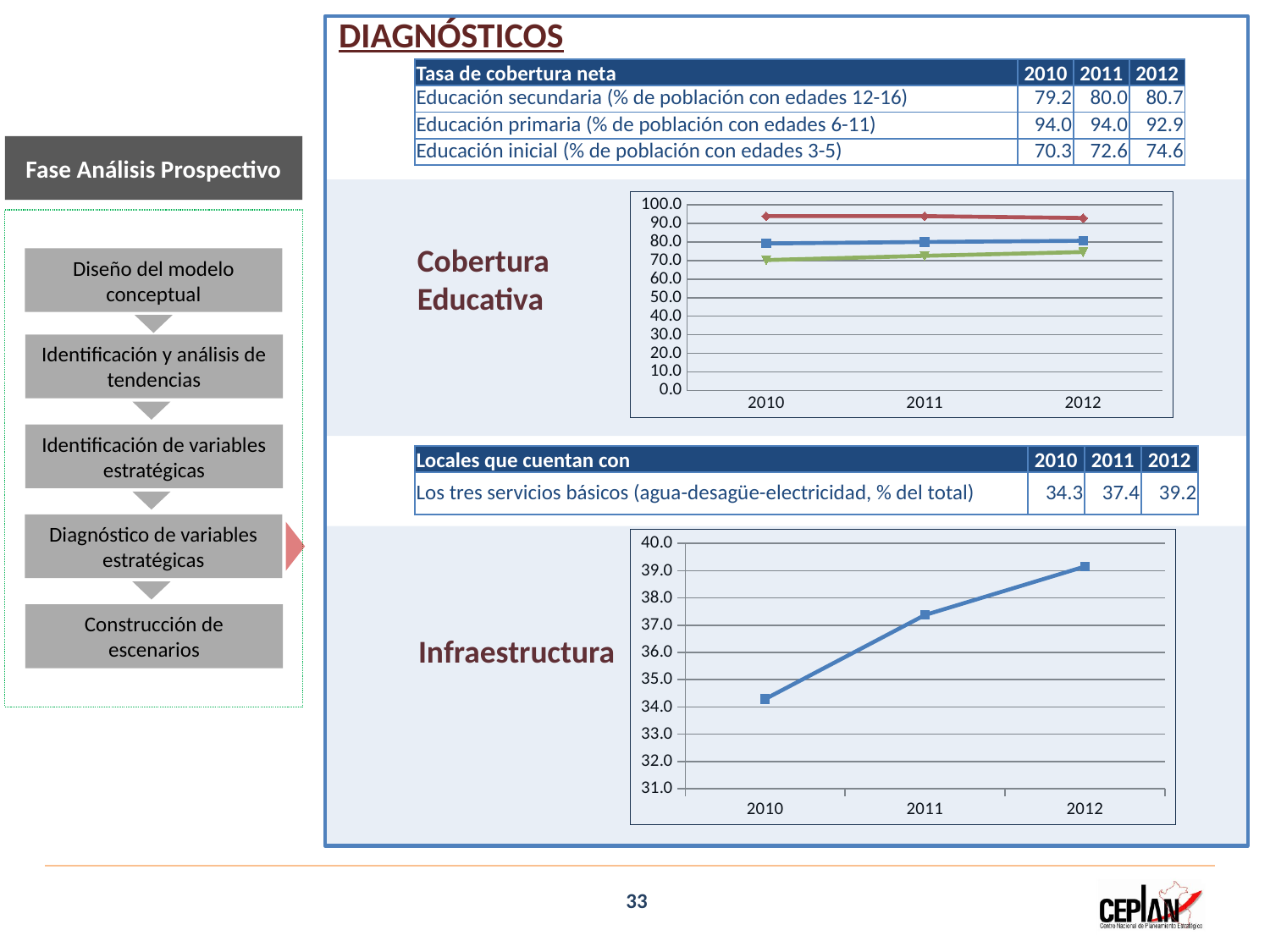
In the Infraestructura chart, which year has the lowest value? 2010 How many lines are plotted in the Cobertura Educativa chart? 3 In the Cobertura Educativa chart, is the value of the red line in 2010 greater or less than 90.0? greater In the Infraestructura chart, which year has the highest value? 2012 In the Cobertura Educativa chart, is the value of the green line in 2010 greater or less than 80.0? less What kind of chart is the Infraestructura chart? line chart In the Infraestructura chart, what is the value for 2012? 39.2 In the Infraestructura chart, do the values rise or fall from 2010 to 2012? rise In the Infraestructura chart, what is the difference between the 2012 and 2010 values? 4.9 What kind of chart is the Cobertura Educativa chart? line chart How many years are plotted on the x axis of the Infraestructura chart? 3 In the Infraestructura chart, what is the value for 2010? 34.3